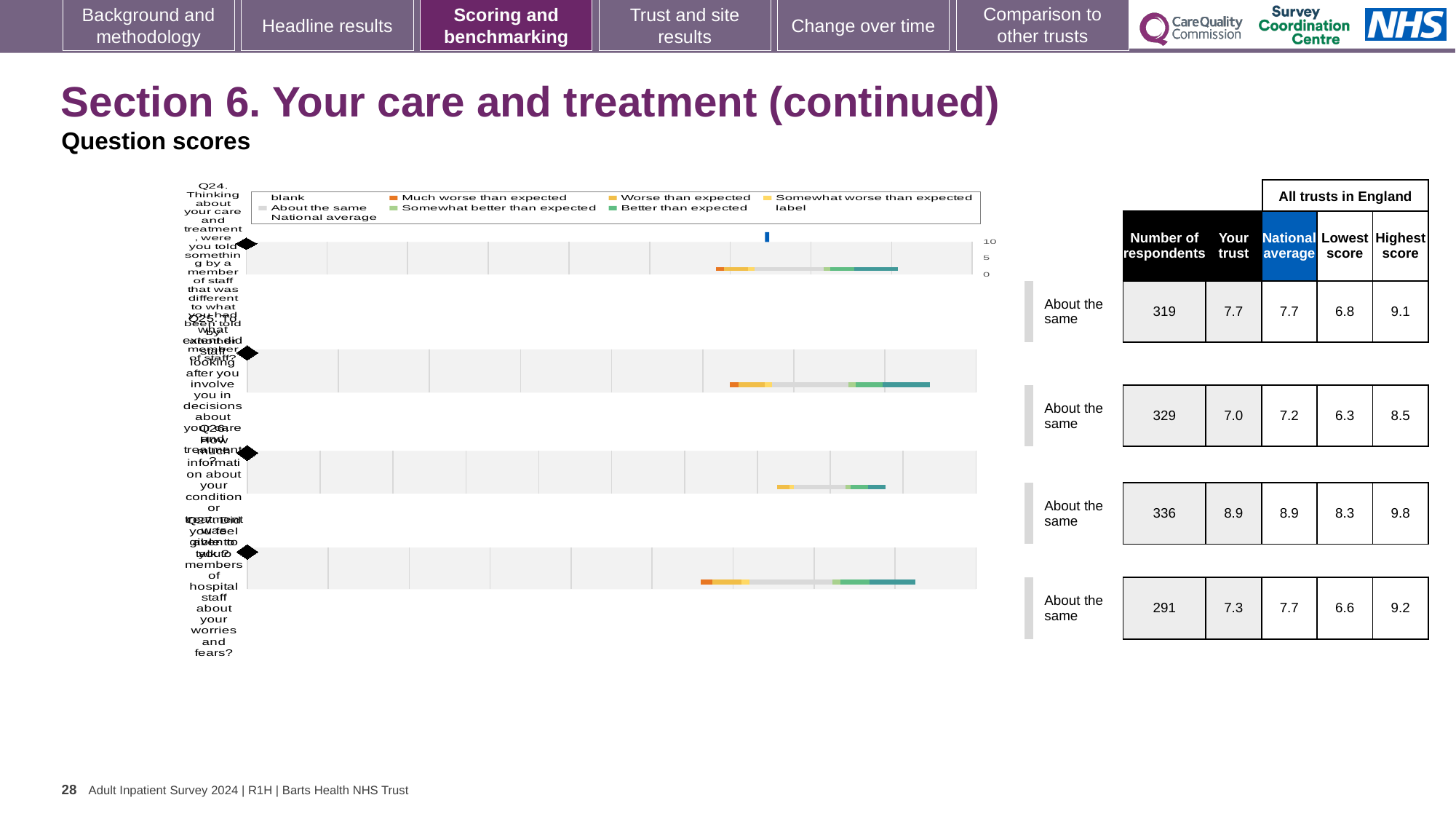
What is the lowest score across all trusts in England for Q25? 6.3 What is the number of respondents for Q24? 319 What is the 'Your trust' score for Q27? 7.3 What is the highest score across all trusts in England for Q26? 9.8 Which question has the highest 'Your trust' score? Q26 What kind of chart is used to show the question scores on this slide? Bar chart How many questions (rows) are plotted in the chart? 4 Which question has the lowest number of respondents? Q27 What is the difference between the national average and the 'Your trust' score for Q27? 0.4 For Q25, which is larger: the 'Your trust' score or the national average? National average Which column header in the table is highlighted in blue? National average What benchmark category is shown for all four questions on this slide? About the same